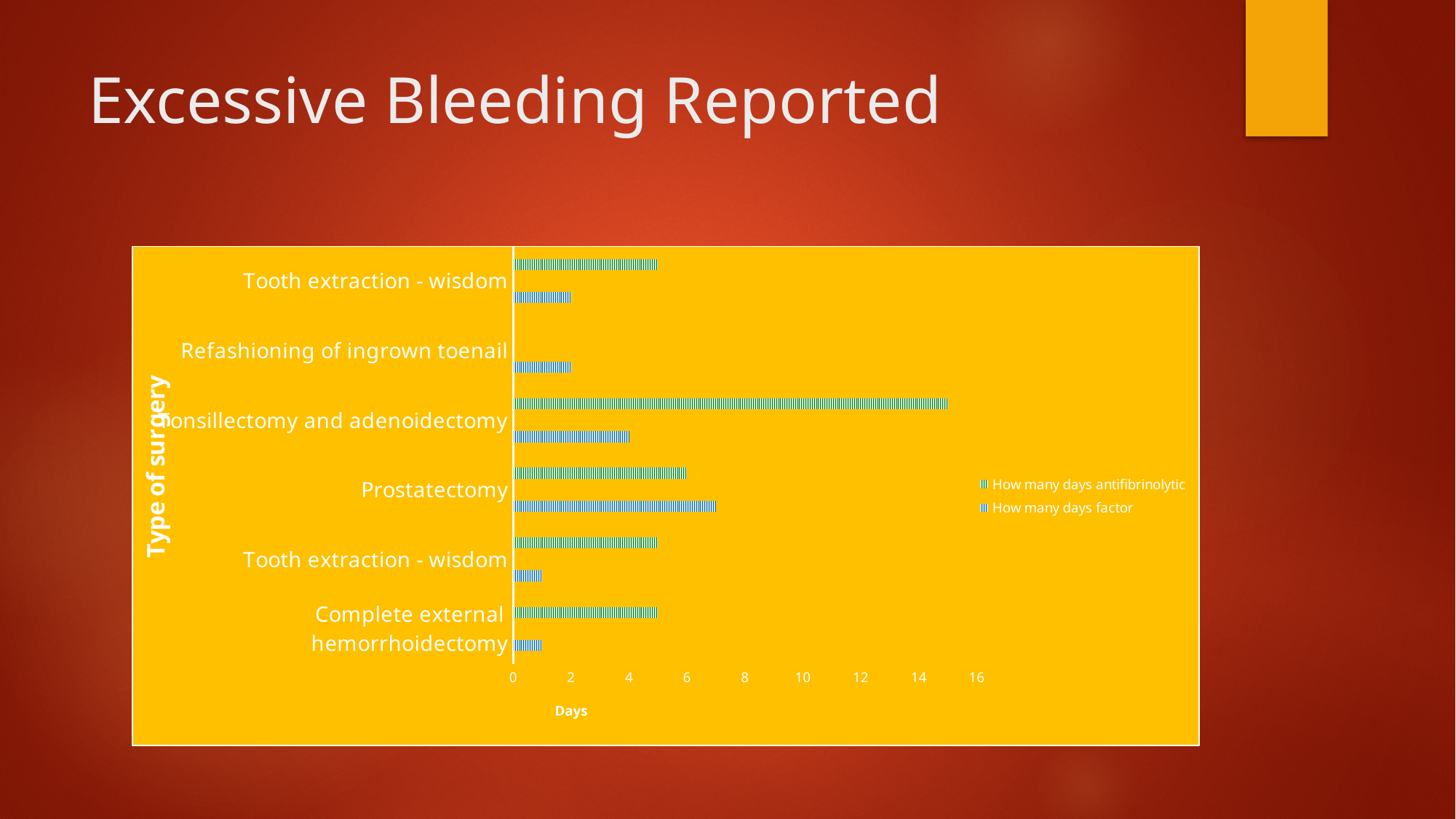
What kind of chart is shown on the slide? bar chart Is the 'How many days antifibrinolytic' value for Tonsillectomy and adenoidectomy greater or less than 14? greater Which is larger: the 'How many days antifibrinolytic' value for Tonsillectomy and adenoidectomy or for Prostatectomy? Tonsillectomy and adenoidectomy How many series does the chart legend list? 2 Is the 'How many days factor' value for Complete external hemorrhoidectomy greater or less than 2? less What is the title of the vertical axis of the chart? Type of surgery What is the 'How many days factor' value for Refashioning of ingrown toenail? 2 Is the 'How many days factor' value for Prostatectomy greater or less than 6? greater How many types of surgery are listed on the vertical axis of the chart? 6 What is the title of the horizontal axis of the chart? Days Which type of surgery has the longest 'How many days antifibrinolytic' bar? Tonsillectomy and adenoidectomy What is the 'How many days factor' value for Tonsillectomy and adenoidectomy? 4